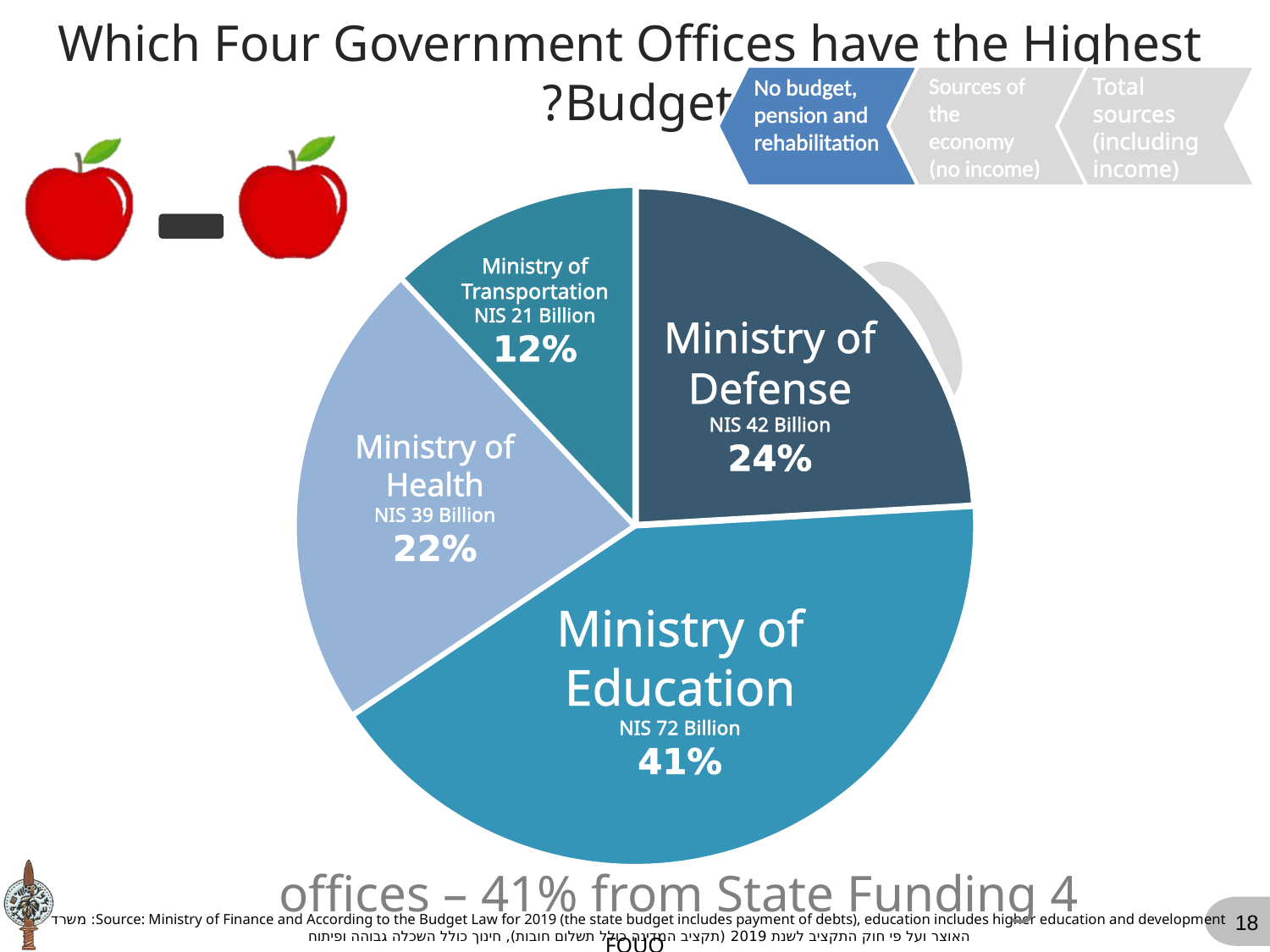
What is the difference in budget between the Ministry of Education and the Ministry of Defense? NIS 30 Billion Which ministry has the smallest slice of the pie chart? Ministry of Transportation What percentage share does the Ministry of Transportation slice show? 12% How many slices does the pie chart have? 4 What kind of chart is shown on the slide? Pie chart Which ministry has the largest slice of the pie chart? Ministry of Education What is the budget of the Ministry of Education shown in the pie chart? NIS 72 Billion What is the difference in percentage share between the Ministry of Health and the Ministry of Transportation? 10% What percentage share does the Ministry of Defense slice show? 24% Which has a larger budget, the Ministry of Health or the Ministry of Transportation? Ministry of Health What is the budget of the Ministry of Health shown in the pie chart? NIS 39 Billion What is the budget of the Ministry of Defense shown in the pie chart? NIS 42 Billion